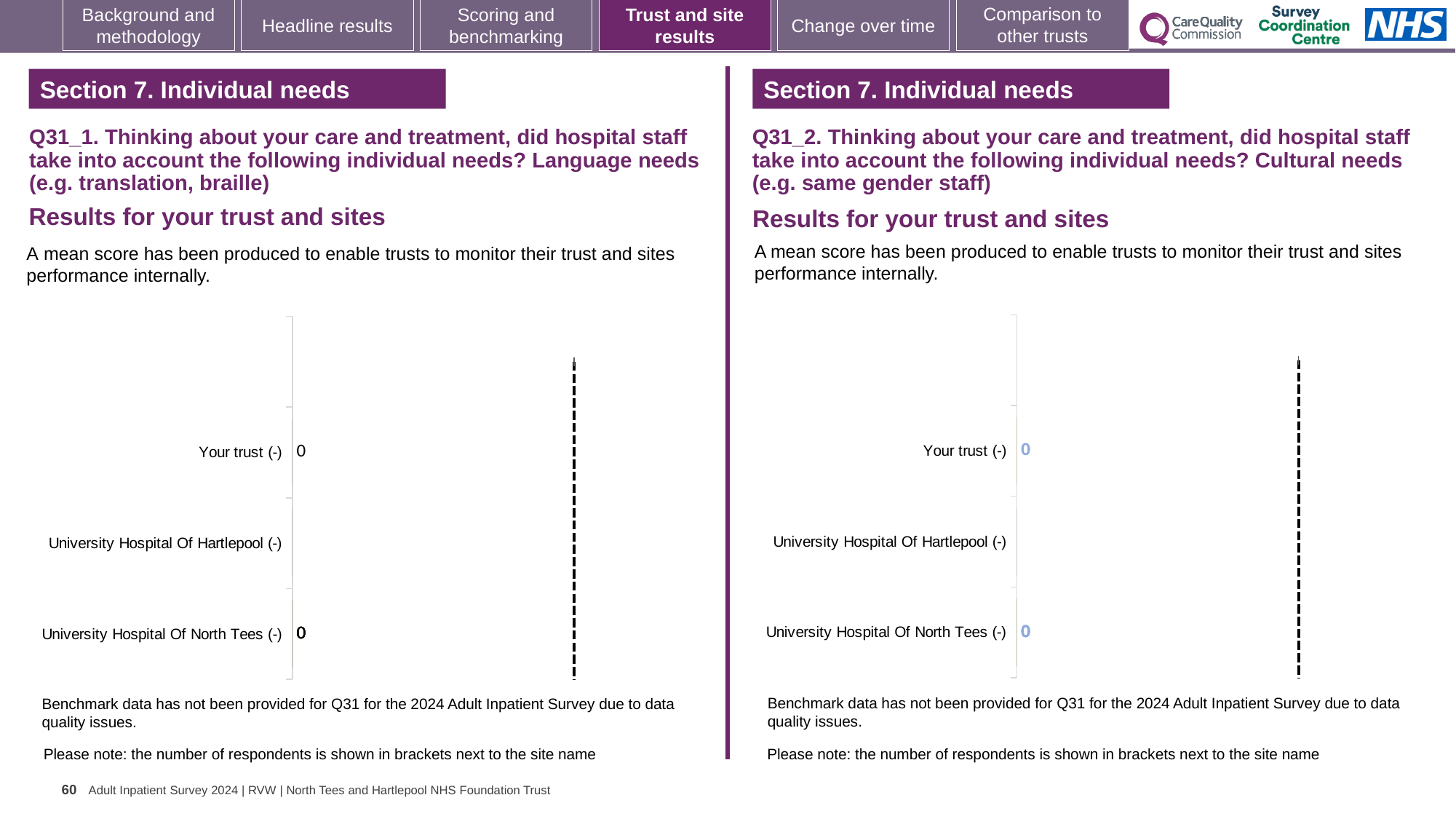
On the right chart (Q31_2, Cultural needs), what is the difference between the values for Your trust (-) and University Hospital Of North Tees (-)? 0 Which category appears at the top of the right chart (Q31_2, Cultural needs)? Your trust (-) Which category appears at the bottom of the left chart (Q31_1, Language needs)? University Hospital Of North Tees (-) How many categories are listed on the left chart (Q31_1, Language needs)? 3 On the right chart (Q31_2, Cultural needs), what is the value shown for Your trust (-)? 0 On the left chart (Q31_1, Language needs), what is the value shown for Your trust (-)? 0 On the left chart (Q31_1, Language needs), what is the difference between the values for Your trust (-) and University Hospital Of North Tees (-)? 0 How many categories are listed on the right chart (Q31_2, Cultural needs)? 3 What kind of chart is the left chart (Q31_1, Language needs)? Bar chart On the left chart (Q31_1, Language needs), what is the value shown for University Hospital Of North Tees (-)? 0 On the right chart (Q31_2, Cultural needs), what is the value shown for University Hospital Of North Tees (-)? 0 What kind of chart is the right chart (Q31_2, Cultural needs)? Bar chart